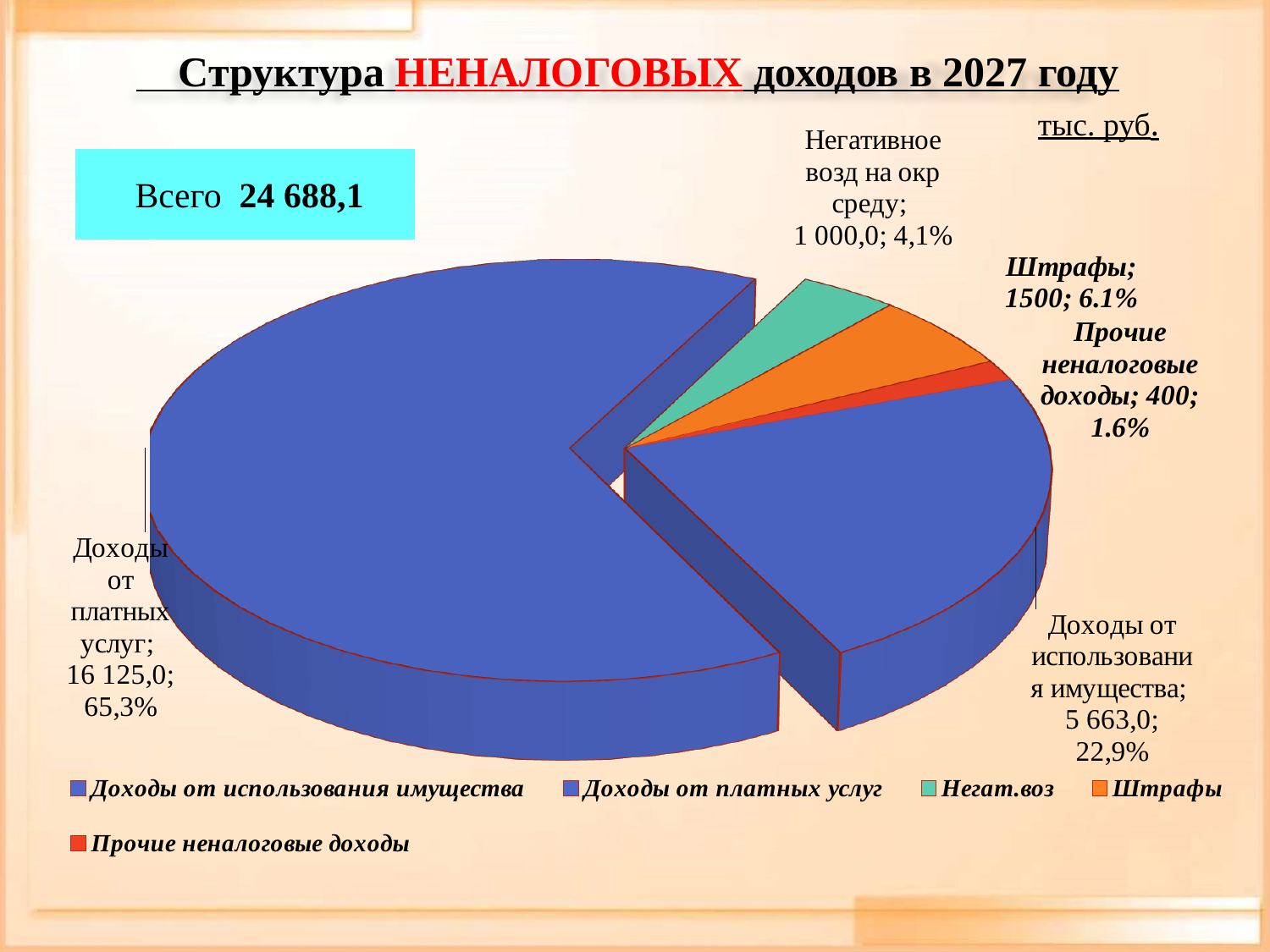
What is the difference between the values for "Штрафы" and "Негативное возд на окр среду"? 500 What is the value for "Доходы от платных услуг"? 16 125,0 Which category has the smallest slice of the pie? Прочие неналоговые доходы What is the value for "Штрафы"? 1500 What is the value for "Прочие неналоговые доходы"? 400 Which category has the largest slice of the pie? Доходы от платных услуг What total ("Всего") is shown on the slide? 24 688,1 How many slices does the pie chart have? 5 What type of chart is shown on the slide? pie chart Which is larger: "Доходы от использования имущества" or "Штрафы"? Доходы от использования имущества What share of the pie does "Доходы от использования имущества" have? 22,9% What percentage is shown for "Негативное возд на окр среду"? 4,1%